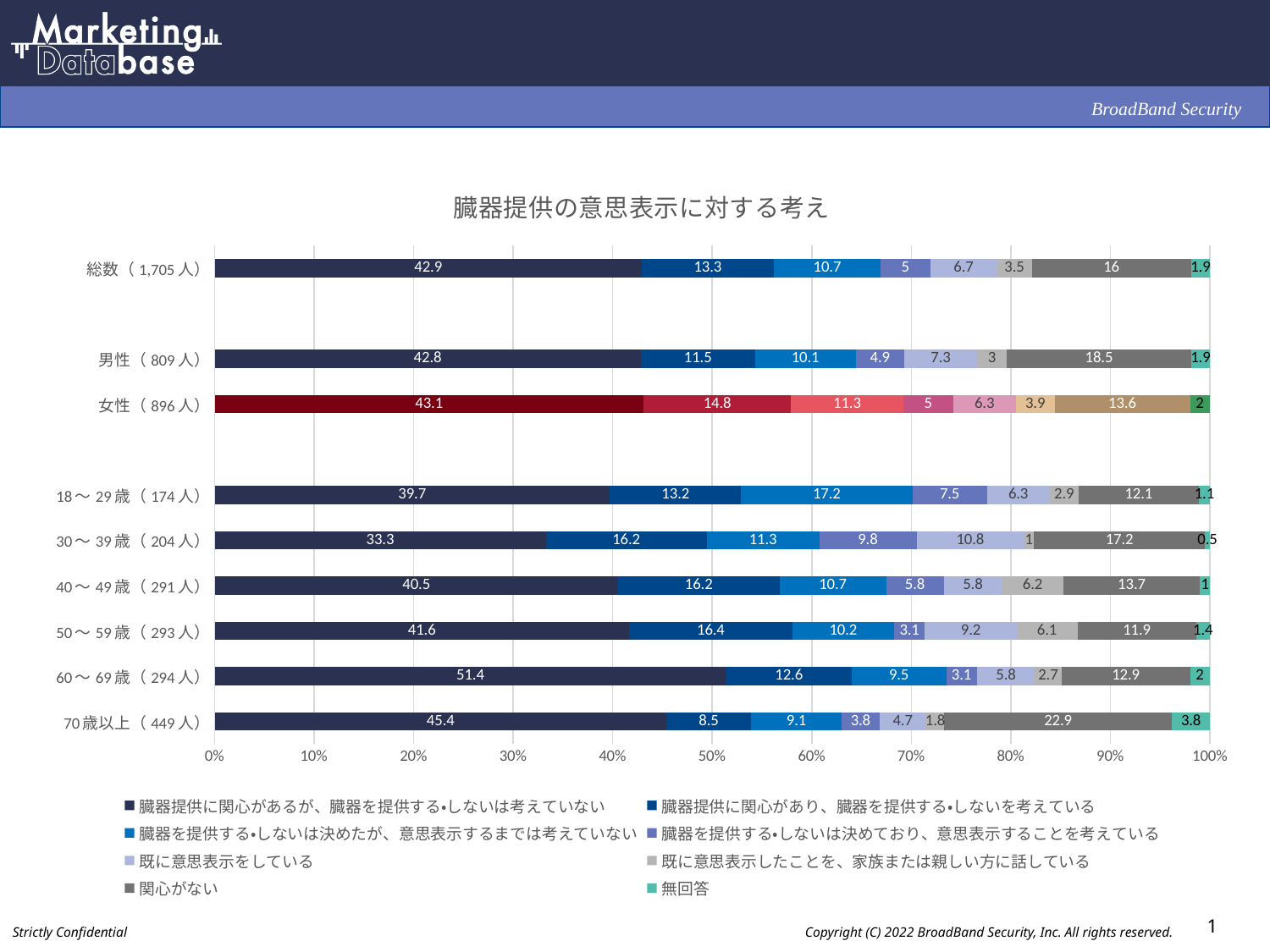
What is the difference between 男性 (809人) and 女性 (896人) for 「関心がない」? 4.9 What is the value of 「臓器を提供する•しないは決めたが、意思表示するまでは考えていない」 for 18～29歳 (174人)? 17.2 What is the value of 「既に意思表示をしている」 for 30～39歳 (204人)? 10.8 How many series does the legend list? 8 What type of chart is shown on the slide? Stacked bar chart Which category has the highest value for 「臓器提供に関心があるが、臓器を提供する•しないは考えていない」? 60～69歳 (294人) What is the value of 「臓器提供に関心があるが、臓器を提供する•しないは考えていない」 for 総数 (1,705人)? 42.9 What is the value of 「関心がない」 for 70歳以上 (449人)? 22.9 Which is larger for 「臓器提供に関心があり、臓器を提供する•しないを考えている」: 18～29歳 (174人) or 70歳以上 (449人)? 18～29歳 (174人) Which category has the lowest value for 「無回答」? 30～39歳 (204人) How many categories (rows) are plotted in the chart? 9 What is the title of the chart? 臓器提供の意思表示に対する考え